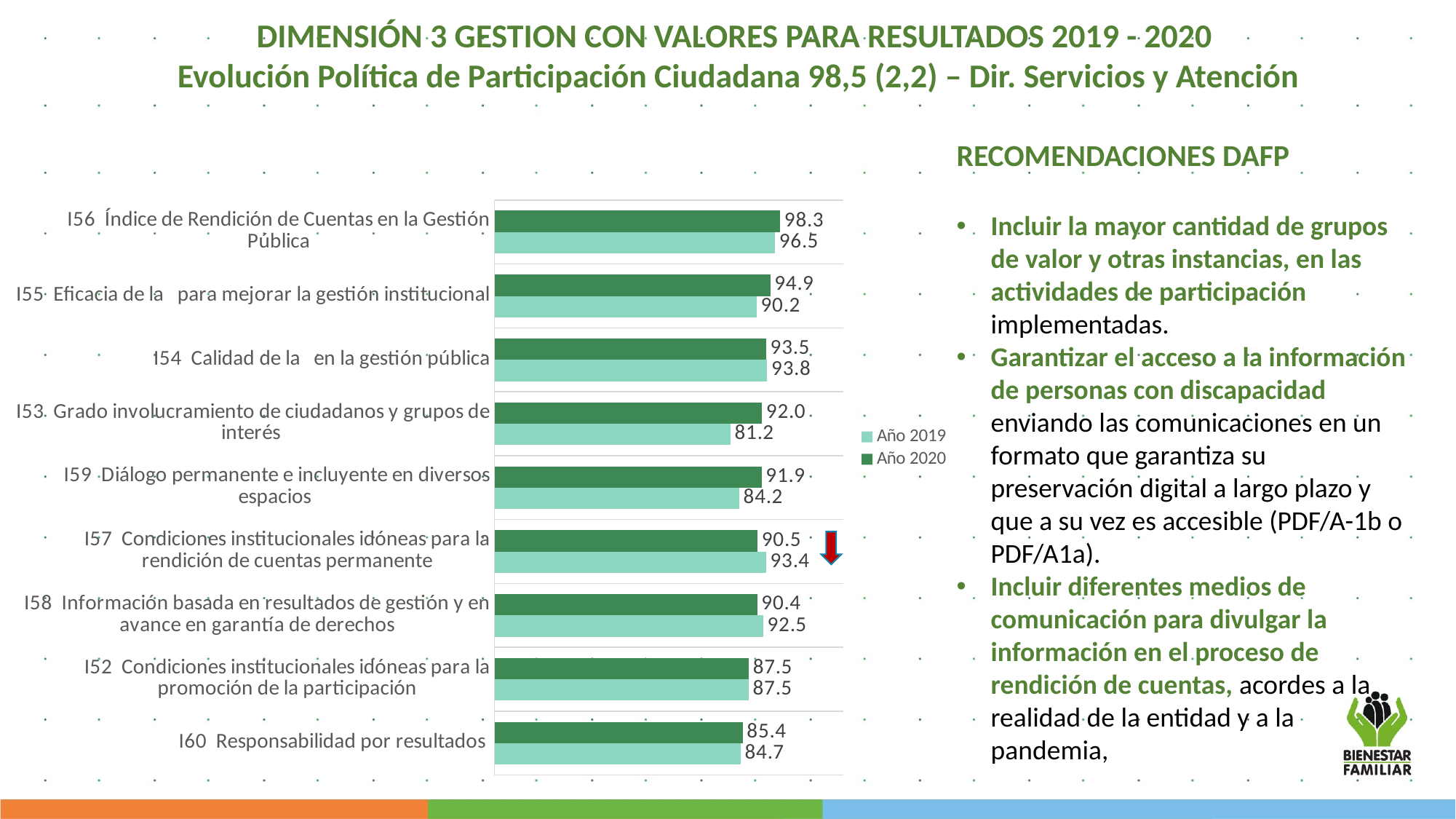
What is the difference between the Año 2020 and Año 2019 values for I53 Grado involucramiento de ciudadanos y grupos de interés? 10.8 For I59 Diálogo permanente e incluyente en diversos espacios, which is larger: the Año 2019 value or the Año 2020 value? Año 2020 What is the difference between the Año 2019 and Año 2020 values for I58 Información basada en resultados de gestión y en avance en garantía de derechos? 2.1 How many categories (indicators) are shown in the chart? 9 What is the Año 2019 value for I57 Condiciones institucionales idóneas para la rendición de cuentas permanente? 93.4 What is the Año 2019 value for I53 Grado involucramiento de ciudadanos y grupos de interés? 81.2 Which category has the lowest Año 2019 value? I53 Grado involucramiento de ciudadanos y grupos de interés Which category has the highest Año 2020 value? I56 Índice de Rendición de Cuentas en la Gestión Pública What kind of chart is shown on the slide? Bar chart What is the Año 2020 value for I56 Índice de Rendición de Cuentas en la Gestión Pública? 98.3 For I57 Condiciones institucionales idóneas para la rendición de cuentas permanente, which is larger: the Año 2019 value or the Año 2020 value? Año 2019 How many series does the legend list? 2